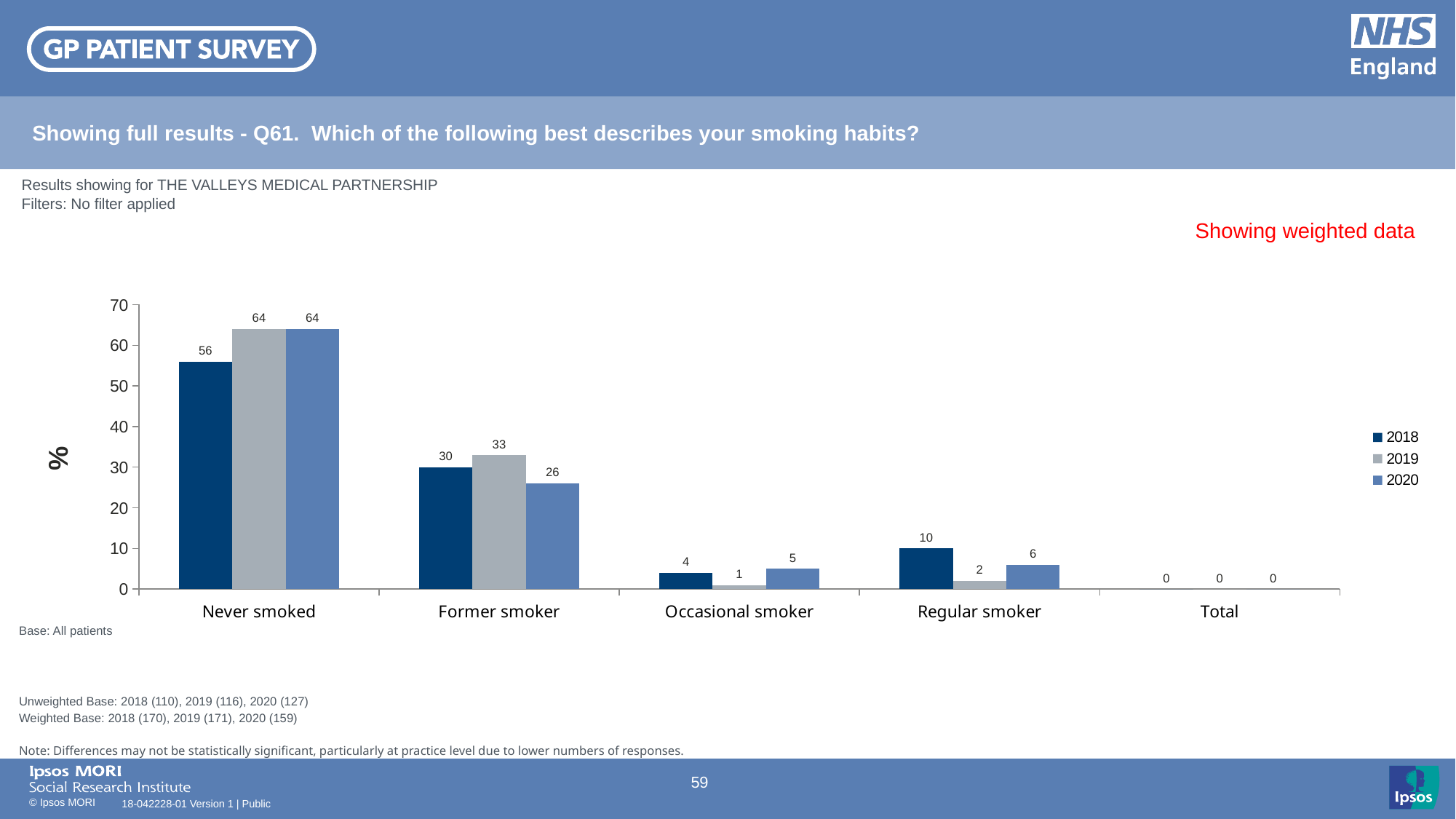
What is the value for Former smoker in 2020? 26 What kind of chart is shown on the slide? Bar chart What is the value for Regular smoker in 2018? 10 What is the value for Occasional smoker in 2019? 1 Which category has the highest value for 2020? Never smoked Which category has the lowest value for 2018, excluding Total? Occasional smoker How many categories are shown on the x axis? 5 Which is larger for Former smoker: the 2019 value or the 2020 value? 2019 What is the difference between the 2019 and 2018 values for Never smoked? 8 What is the value for Never smoked in 2018? 56 How many series does the legend list? 3 Which series is shown in grey in the legend? 2019